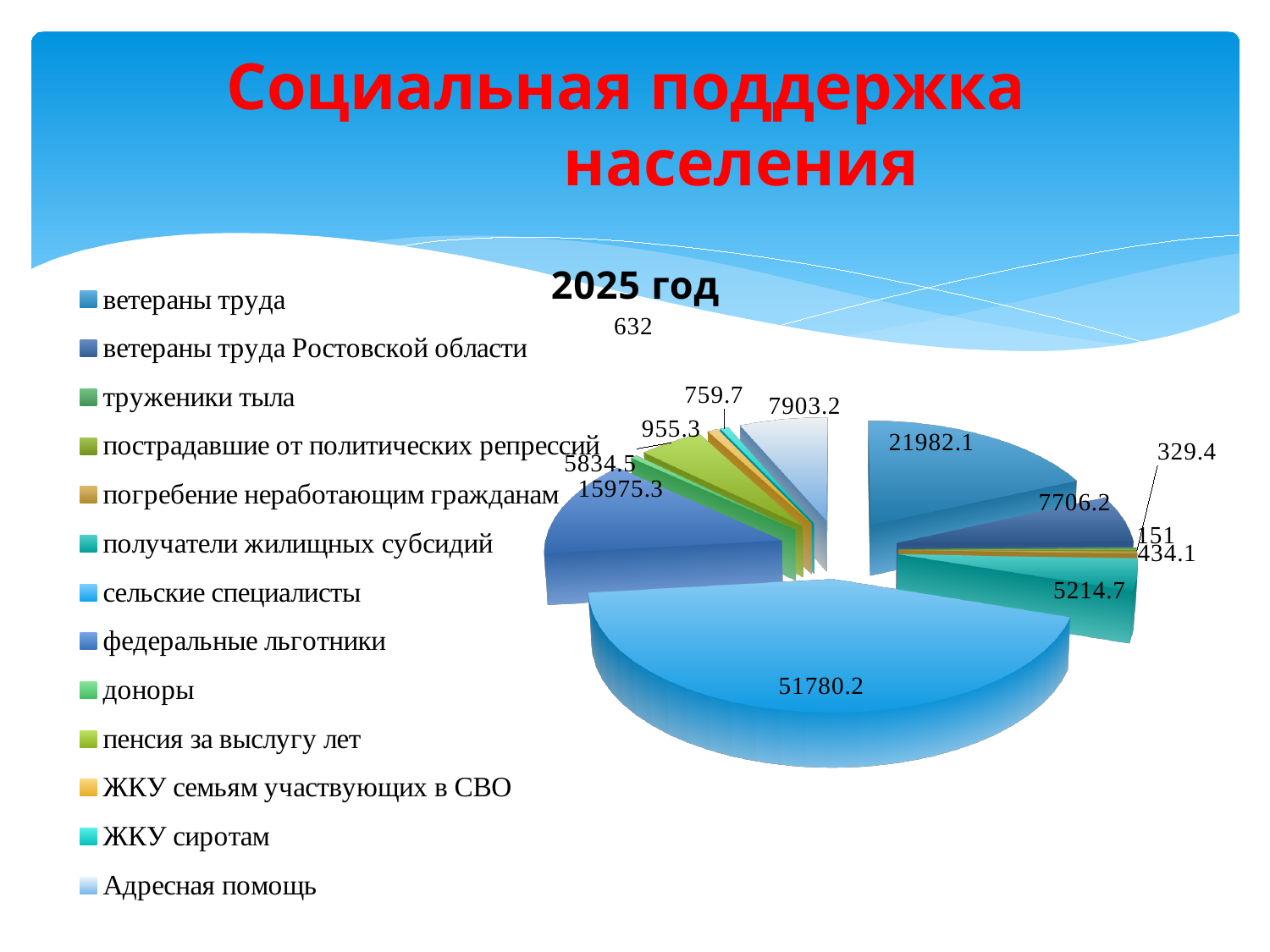
What is the title of the chart? 2025 год What is the largest value shown on the pie chart? 51780.2 How many categories does the legend of the pie chart list? 13 What is the value for получатели жилищных субсидий? 5214.7 What is the value for ветераны труда? 21982.1 Which is larger, the slice labelled 21982.1 or the slice labelled 15975.3? 21982.1 What is the value for ветераны труда Ростовской области? 7706.2 What is the smallest value shown on the pie chart? 151 What is the value for Адресная помощь? 7903.2 What kind of chart is shown on the slide? pie chart What is the difference between the value for ветераны труда (21982.1) and the value for ветераны труда Ростовской области (7706.2)? 14275.9 Which legend entry is listed last in the legend? Адресная помощь